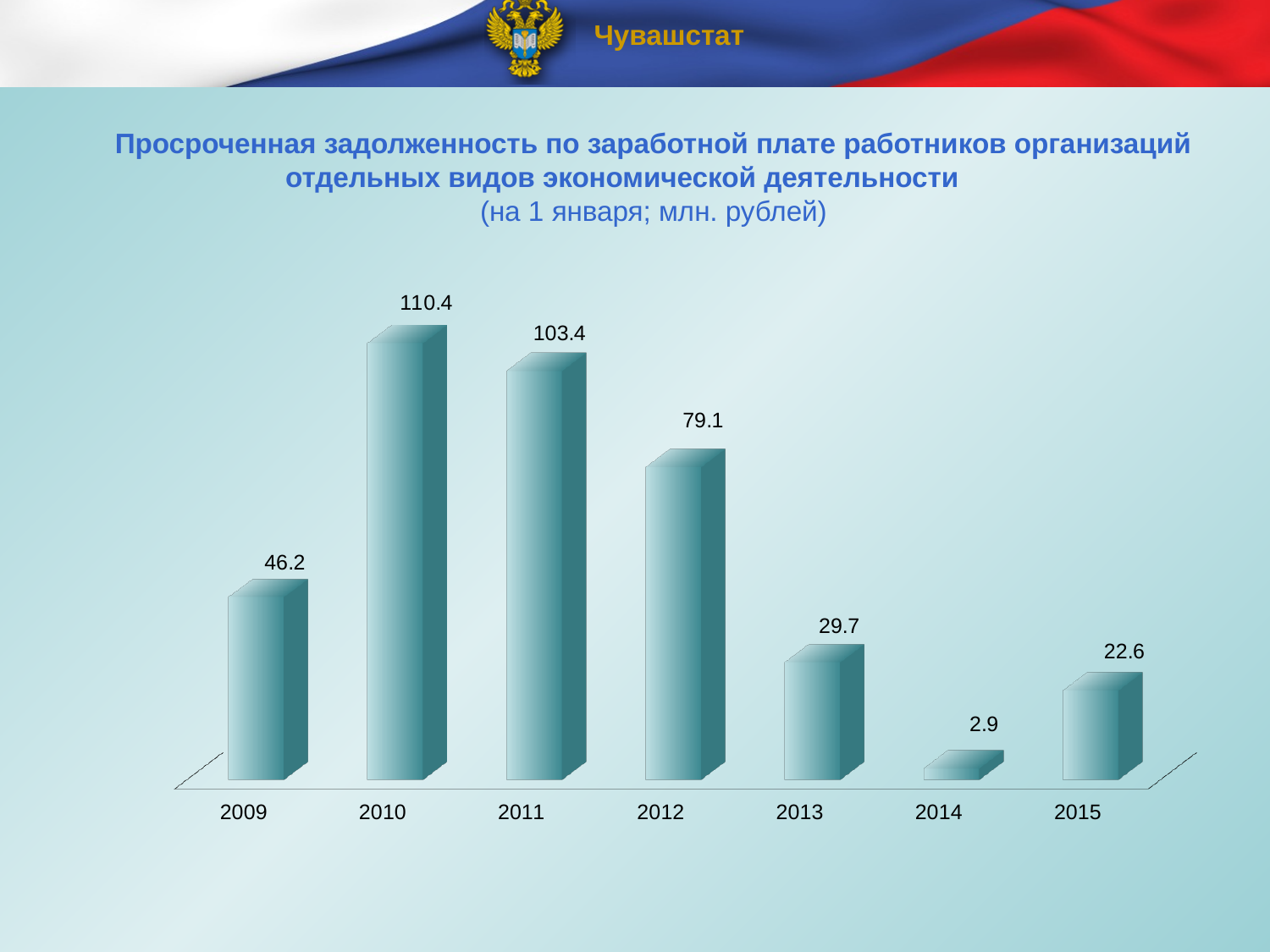
Which is larger, the value for 2009 or the value for 2013? 2009 What unit is stated in the chart subtitle? млн. рублей What is the value for 2010? 110.4 Which year has the highest value? 2010 How many years are shown on the x axis? 7 What is the difference between the values for 2013 and 2015? 7.1 What is the difference between the values for 2010 and 2011? 7.0 Do the values rise or fall from 2011 to 2014? fall What kind of chart is this? bar chart What is the value for 2014? 2.9 Which year has the lowest value? 2014 What is the value for 2012? 79.1